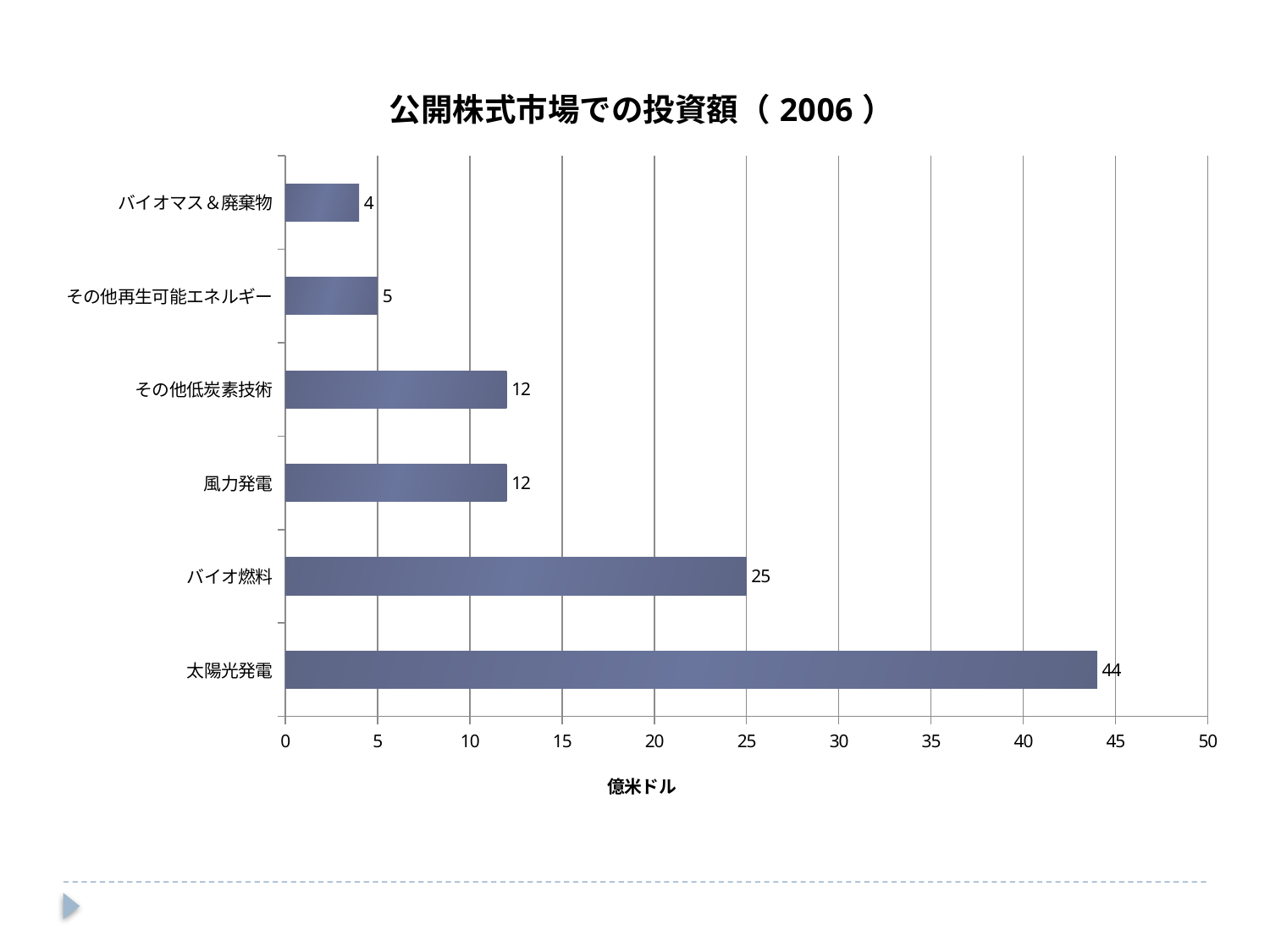
Is the value for バイオ燃料 greater or less than 20? greater What kind of chart is shown on the slide? bar chart What is the value for バイオ燃料? 25 Which category has the highest value? 太陽光発電 How many categories are shown in the chart? 6 What is the difference between the values for 太陽光発電 and バイオ燃料? 19 What is the value for バイオマス＆廃棄物? 4 Which category has the lowest value? バイオマス＆廃棄物 What is the value for 太陽光発電? 44 What is the value for その他再生可能エネルギー? 5 What is the label of the horizontal axis? 億米ドル Which is larger, the value for 風力発電 or the value for その他再生可能エネルギー? 風力発電